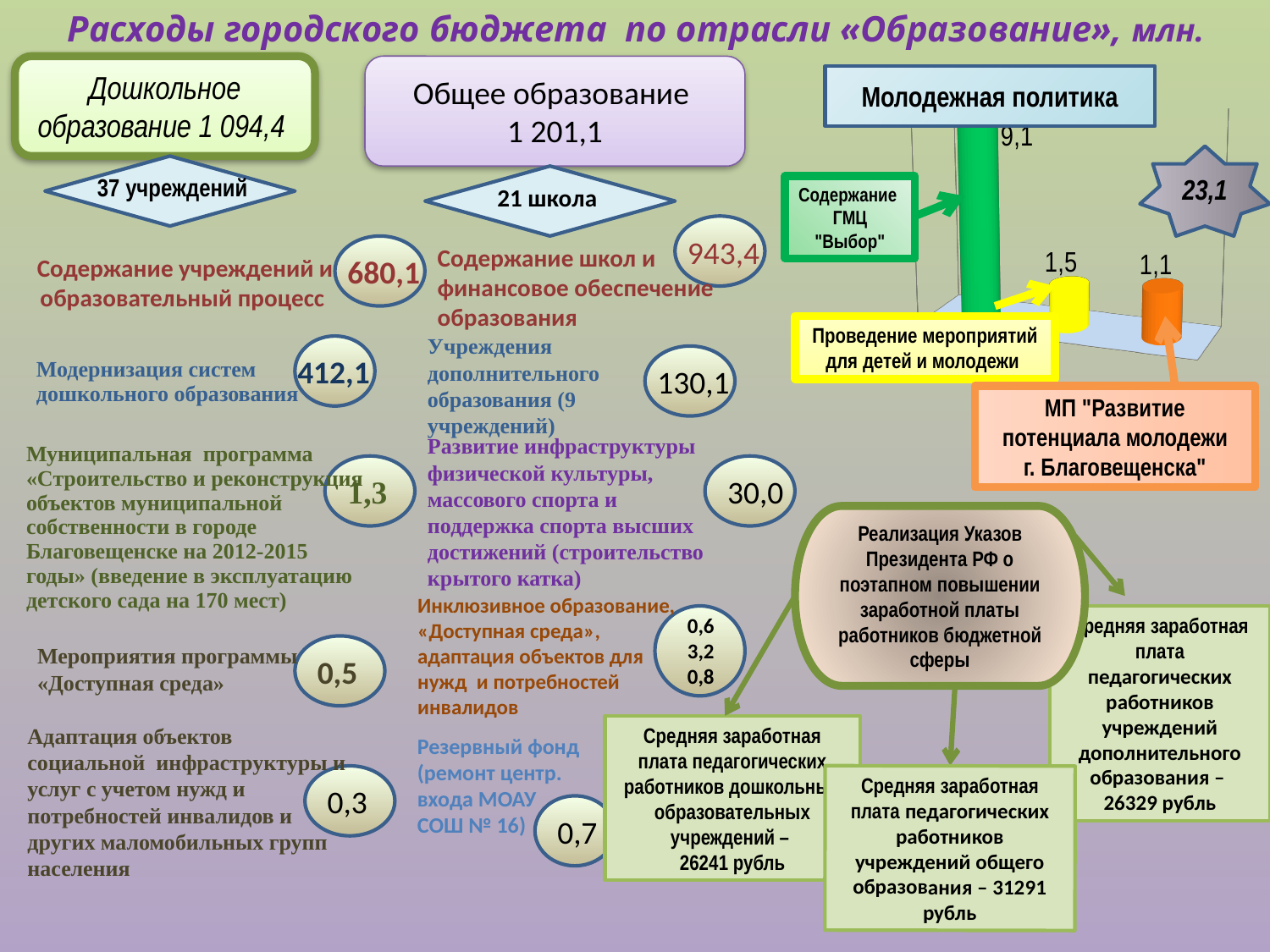
In the chart under "Молодежная политика", what is the value for МП "Развитие потенциала молодежи г. Благовещенска"? 1,1 In the chart under "Молодежная политика", which item has the lowest value? МП "Развитие потенциала молодежи г. Благовещенска" In the chart under "Молодежная политика", what is the difference between the value for Содержание ГМЦ "Выбор" and the value for МП "Развитие потенциала молодежи г. Благовещенска"? 8,0 In the chart under "Молодежная политика", which is larger: the value for Проведение мероприятий для детей и молодежи or the value for МП "Развитие потенциала молодежи г. Благовещенска"? Проведение мероприятий для детей и молодежи In the chart under "Молодежная политика", what is the value for Проведение мероприятий для детей и молодежи? 1,5 In the chart under "Молодежная политика", what is the difference between the value for Содержание ГМЦ "Выбор" and the value for Проведение мероприятий для детей и молодежи? 7,6 In the chart under "Молодежная политика", what is the value for Содержание ГМЦ "Выбор"? 9,1 In the chart under "Молодежная политика", which item has the highest value? Содержание ГМЦ "Выбор" In the chart under "Молодежная политика", what colour is the tallest bar? green In the chart under "Молодежная политика", what is the difference between the value for Проведение мероприятий для детей и молодежи and the value for МП "Развитие потенциала молодежи г. Благовещенска"? 0,4 How many bars are plotted in the chart under "Молодежная политика"? 3 What kind of chart is shown under "Молодежная политика"? bar chart